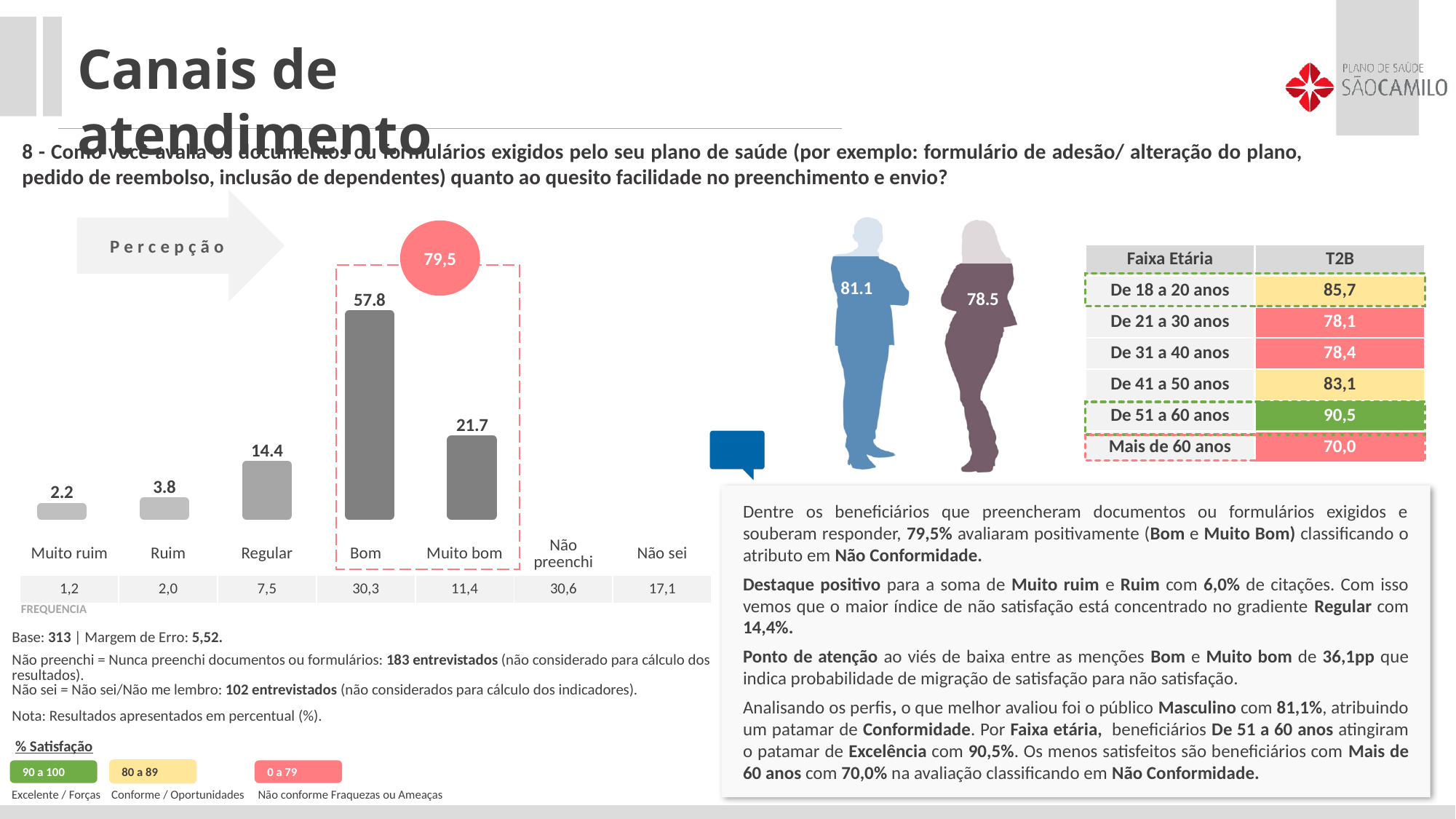
In the bar chart, what is the value for Ruim? 3.8 Which category has the highest bar in the bar chart? Bom In the bar chart, what is the sum of the values for Muito ruim and Ruim? 6.0 How many bars are plotted in the bar chart? 5 What kind of chart is shown on the left of the slide? bar chart In the bar chart, what is the value for Regular? 14.4 In the bar chart, which is larger, the value for Regular or the value for Muito bom? Muito bom In the bar chart, what is the value for Muito bom? 21.7 In the bar chart, what is the difference between the values for Bom and Muito bom? 36.1 What value is shown in the red circle above the Bom and Muito bom bars? 79,5 In the bar chart, what is the value for Bom? 57.8 Which category has the lowest bar in the bar chart? Muito ruim